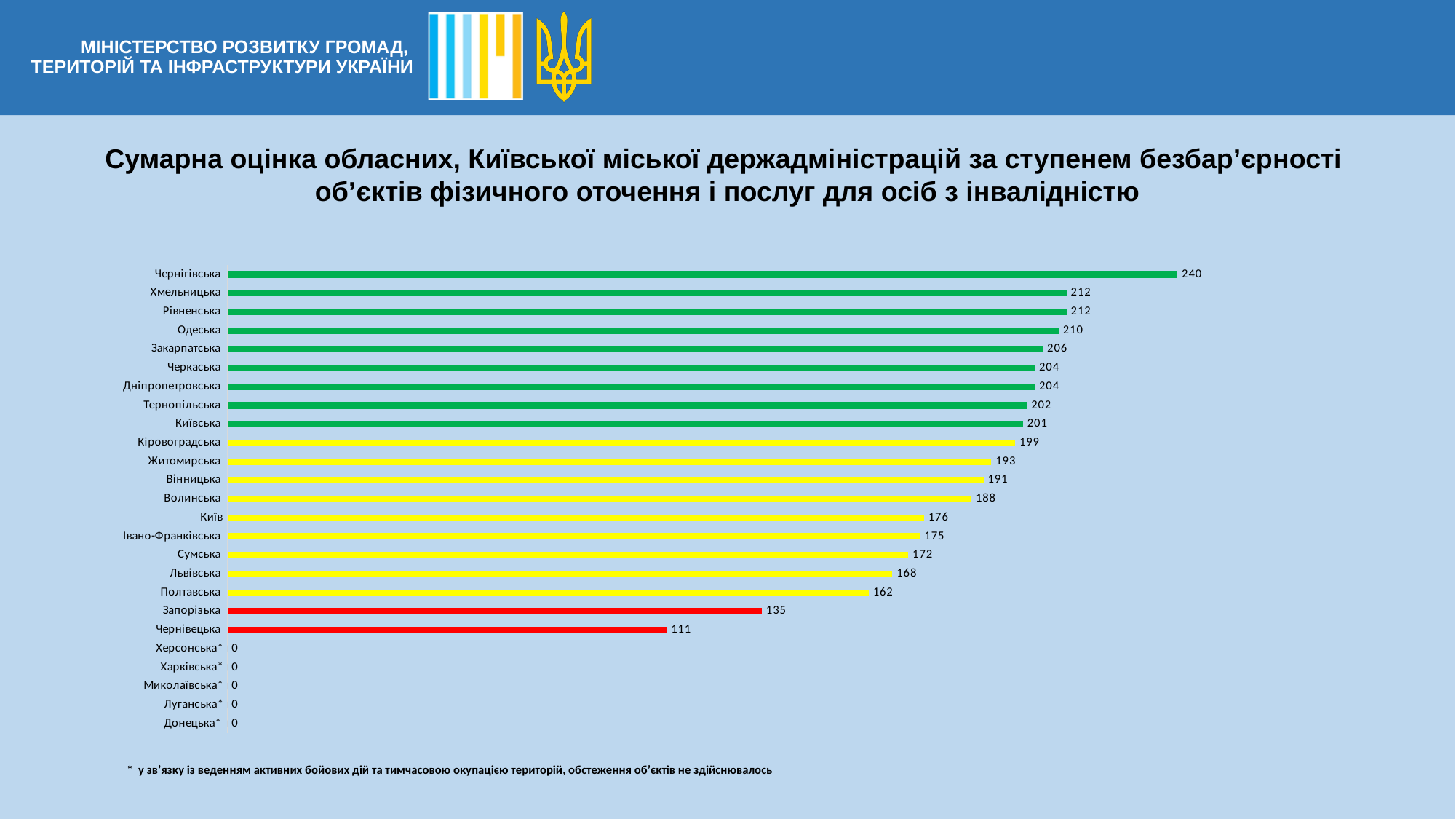
What is the value for Чернігівська? 240 What is the value for Київ? 176 How many categories have a value of 0? 5 Which category has the lowest non-zero value? Чернівецька Which has a larger value, Одеська or Полтавська? Одеська What type of chart is shown on the slide? bar chart How many categories are shown on the chart? 25 What is the value for Запорізька? 135 Which category has the highest value? Чернігівська What is the difference between the values for Чернігівська and Чернівецька? 129 What colour are the bars for Запорізька and Чернівецька? red What is the difference between the values for Кіровоградська and Волинська? 11